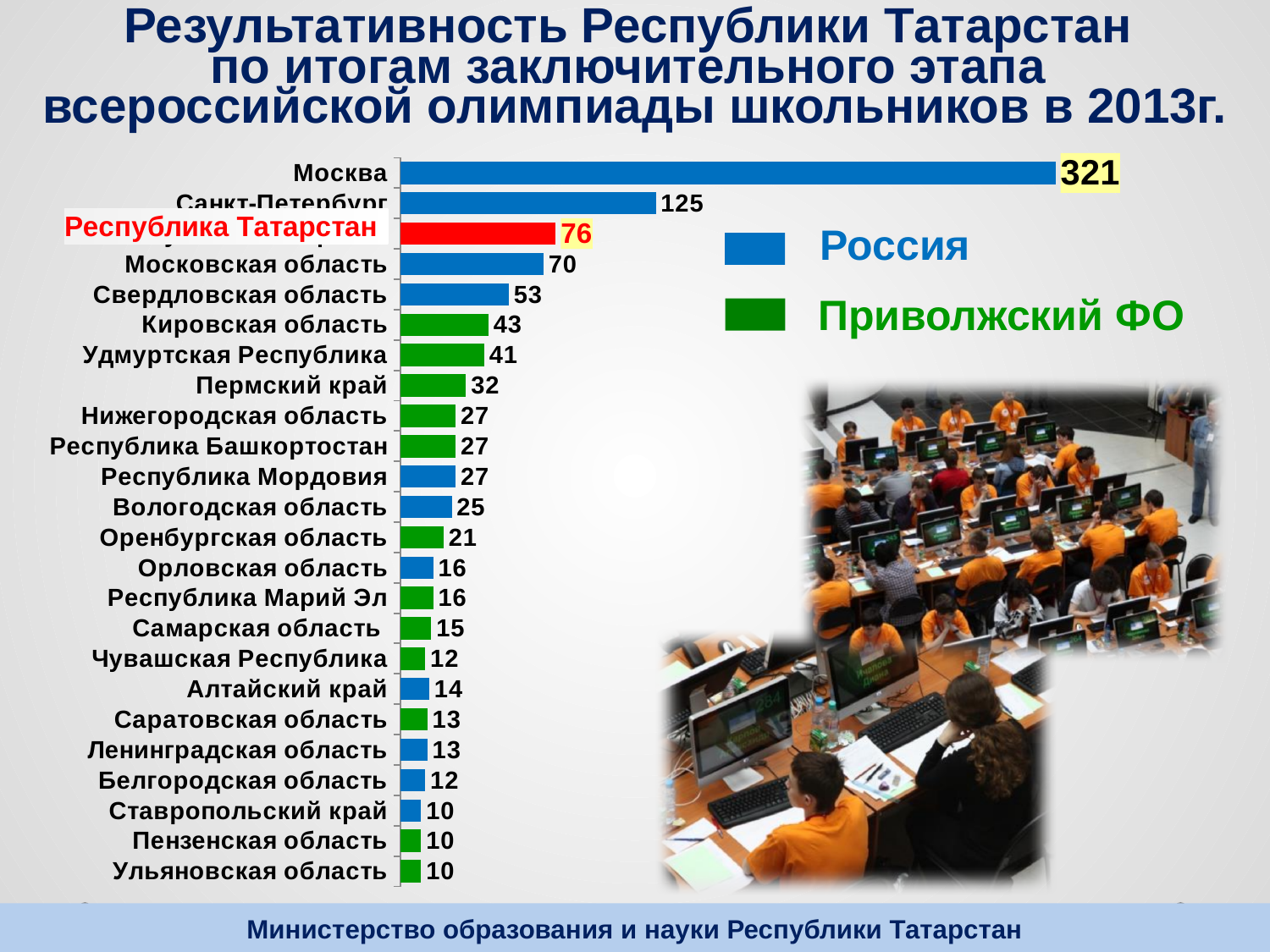
How many entries does the legend list? 2 How many categories are shown in the chart? 24 What is the value for Кировская область? 43 What is the difference between the values for Москва and Санкт-Петербург? 196 Which category has the highest value? Москва What kind of chart is shown on the slide? Bar chart What is the value for Республика Татарстан? 76 What is the value for Москва? 321 What is the difference between the values for Республика Татарстан and Московская область? 6 Which legend entry is shown in green? Приволжский ФО Which is larger, the value for Удмуртская Республика or the value for Пермский край? Удмуртская Республика What is the value for Ульяновская область? 10